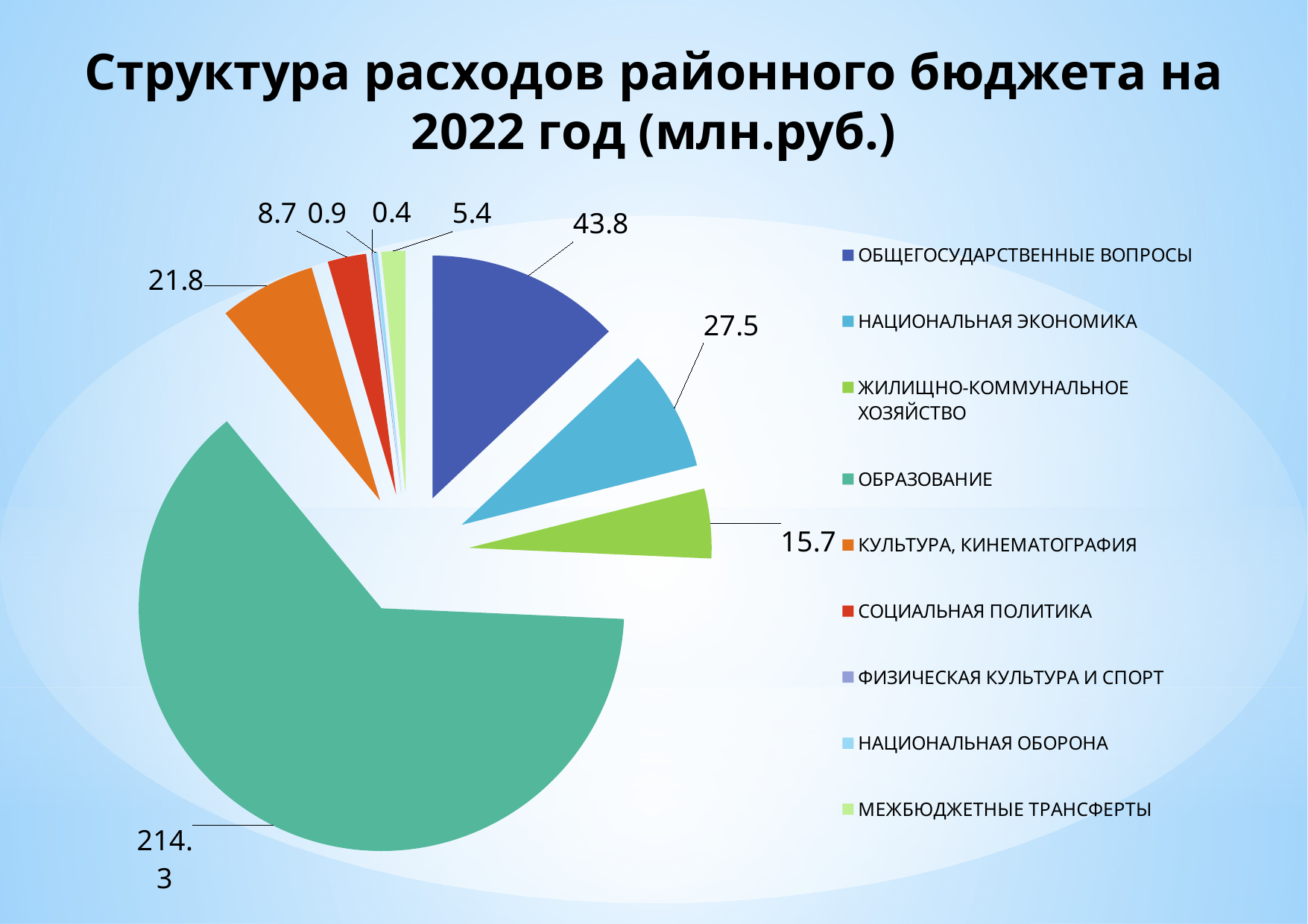
Which category has the largest slice of the pie? ОБРАЗОВАНИЕ What is the value for КУЛЬТУРА, КИНЕМАТОГРАФИЯ? 21.8 How many categories does the legend list? 9 What is the value for ОБРАЗОВАНИЕ? 214.3 What is the value for СОЦИАЛЬНАЯ ПОЛИТИКА? 8.7 What is the title of the chart? Структура расходов районного бюджета на 2022 год (млн.руб.) Which category has the smallest slice of the pie? ФИЗИЧЕСКАЯ КУЛЬТУРА И СПОРТ What is the value for НАЦИОНАЛЬНАЯ ЭКОНОМИКА? 27.5 What is the difference between the values for ОБЩЕГОСУДАРСТВЕННЫЕ ВОПРОСЫ and НАЦИОНАЛЬНАЯ ЭКОНОМИКА? 16.3 What kind of chart is shown on the slide? pie chart What is the value for ОБЩЕГОСУДАРСТВЕННЫЕ ВОПРОСЫ? 43.8 Which is larger, the value for ЖИЛИЩНО-КОММУНАЛЬНОЕ ХОЗЯЙСТВО or the value for КУЛЬТУРА, КИНЕМАТОГРАФИЯ? КУЛЬТУРА, КИНЕМАТОГРАФИЯ